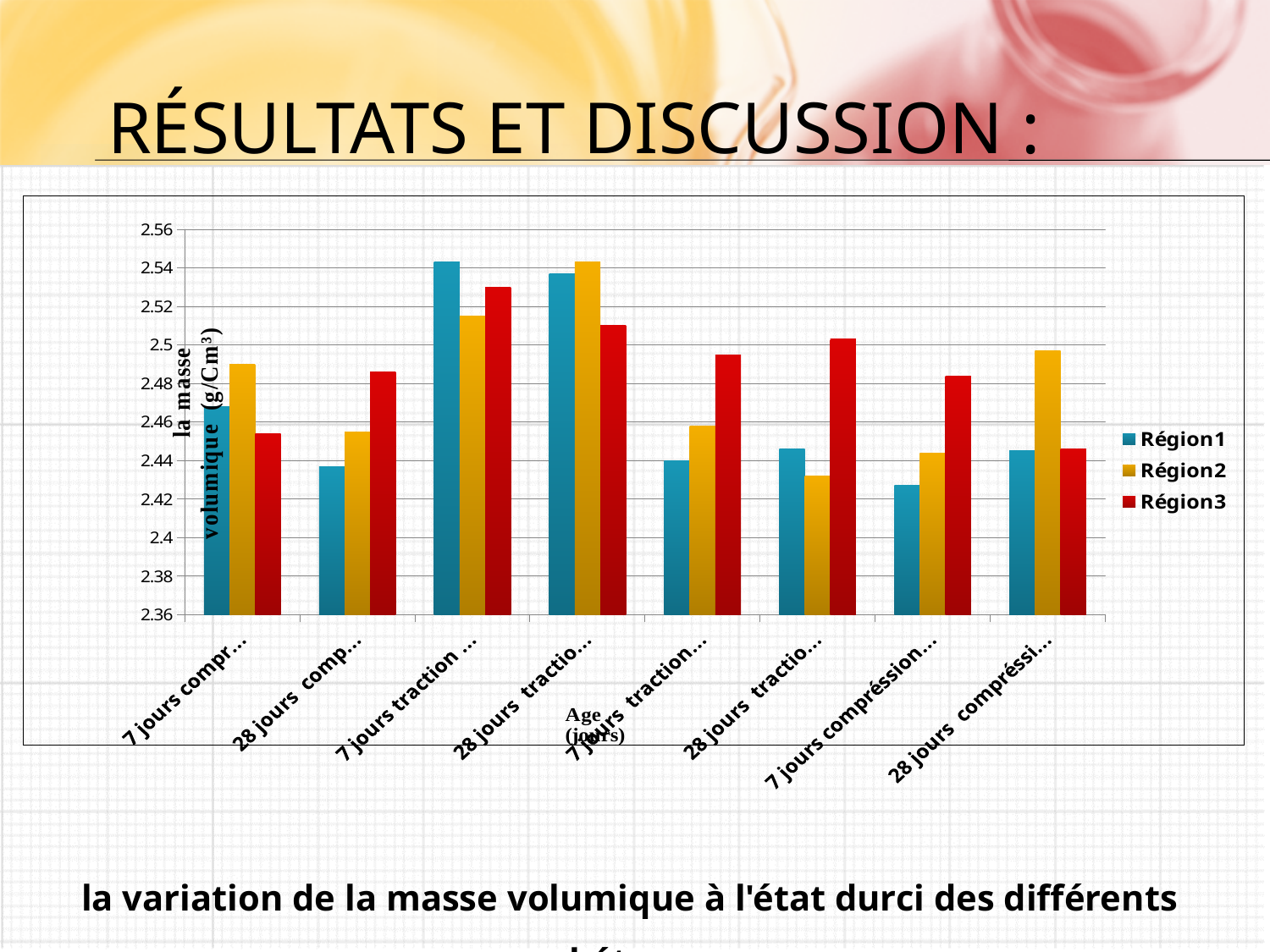
In the sixth category group (28 jours tractio...), which series has the shortest bar? Région2 Is the Région3 value in the first category group greater or less than 2.46? less In the first category group, which is larger: the Région2 bar or the Région3 bar? Région2 Which series is drawn in red? Région3 How many series does the legend list? 3 In the first category group (7 jours compr...), which series has the tallest bar? Région2 What kind of chart is shown on the slide? bar chart How many category groups are plotted along the x axis? 8 In the second category group (28 jours comp...), which series has the tallest bar? Région3 What is the label of the vertical axis? la masse volumique (g/Cm³) In the fifth category group (7 jours traction...), which is larger: the Région1 bar or the Région3 bar? Région3 Is the Région1 value in the third category group (7 jours traction ...) greater or less than 2.52? greater